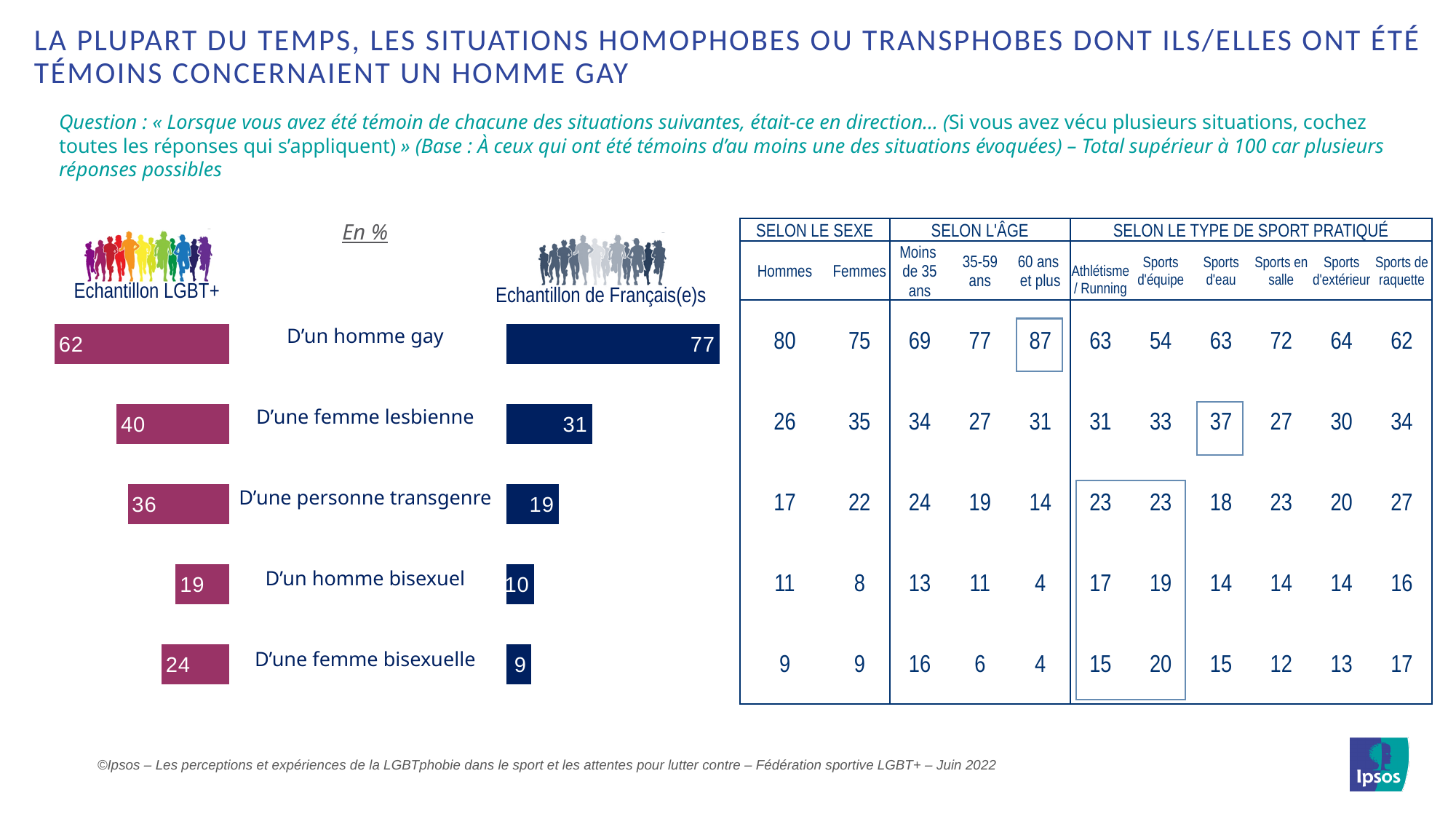
In the Echantillon LGBT+ chart, what is the difference between the values for "D'un homme gay" and "D'une femme lesbienne"? 22 In the Echantillon LGBT+ chart, which category has the highest value? D'un homme gay How many categories does the Echantillon LGBT+ chart show? 5 In the Echantillon de Français(e)s chart, which category has the lowest value? D'une femme bisexuelle In the Echantillon LGBT+ chart, what is the value for "D'un homme gay"? 62 In the Echantillon de Français(e)s chart, what is the value for "D'une femme lesbienne"? 31 In the Echantillon LGBT+ chart, which is larger: "D'un homme bisexuel" or "D'une femme bisexuelle"? D'une femme bisexuelle In the Echantillon de Français(e)s chart, what is the difference between the values for "D'un homme gay" and "D'une personne transgenre"? 58 In what unit are the values in the two bar charts expressed? % What type of chart is used for the Echantillon de Français(e)s data? Bar chart Which is larger: the value for "D'une personne transgenre" in the Echantillon LGBT+ chart or in the Echantillon de Français(e)s chart? Echantillon LGBT+ In the Echantillon LGBT+ chart, which category has the lowest value? D'un homme bisexuel